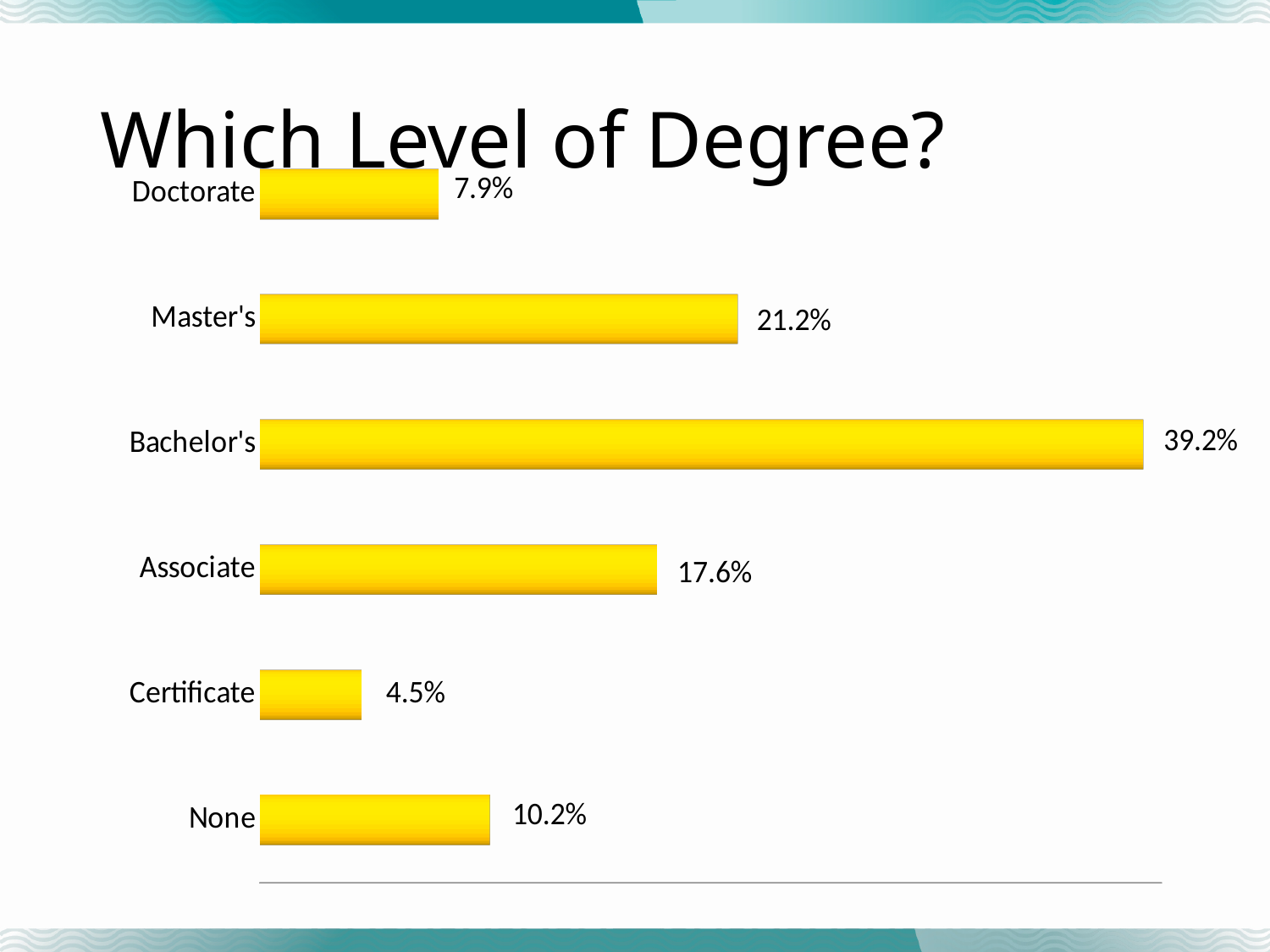
What is the difference between the Master's and Associate percentages? 3.6% Which degree level has the lowest percentage? Certificate What percentage is shown for None? 10.2% What percentage is shown for Certificate? 4.5% What is the title of the slide? Which Level of Degree? How many degree levels are shown in the chart? 6 What percentage is shown for Doctorate? 7.9% What is the difference between the Bachelor's and Doctorate percentages? 31.3% Which degree level has the highest percentage? Bachelor's Which is larger, the percentage for None or the percentage for Doctorate? None What percentage is shown for Bachelor's? 39.2% What type of chart is shown on the slide? Bar chart